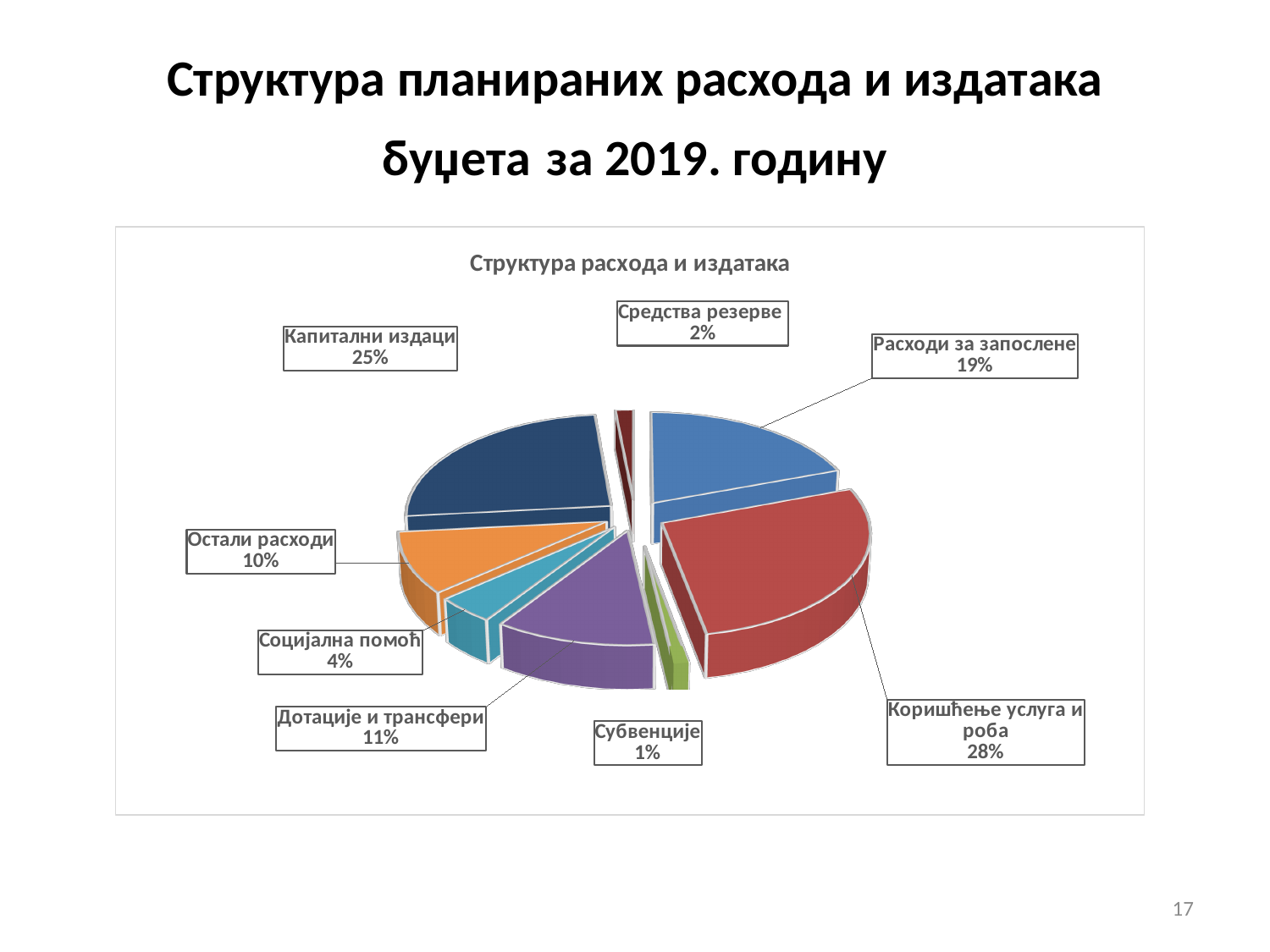
What is the value for Капитални издаци? 25% What share of the pie does Коришћење услуга и роба have? 28% Which is larger, Дотације и трансфери or Остали расходи? Дотације и трансфери What is the value for Социјална помоћ? 4% Which category has the smallest share of the pie? Субвенције What is the chart's title? Структура расхода и издатака What kind of chart is shown on the slide? Pie chart How many slices does the pie chart have? 8 What is the value for Расходи за запослене? 19% Which category has the largest share of the pie? Коришћење услуга и роба What is the value for Средства резерве? 2% What is the difference between the shares of Коришћење услуга и роба and Капитални издаци? 3%